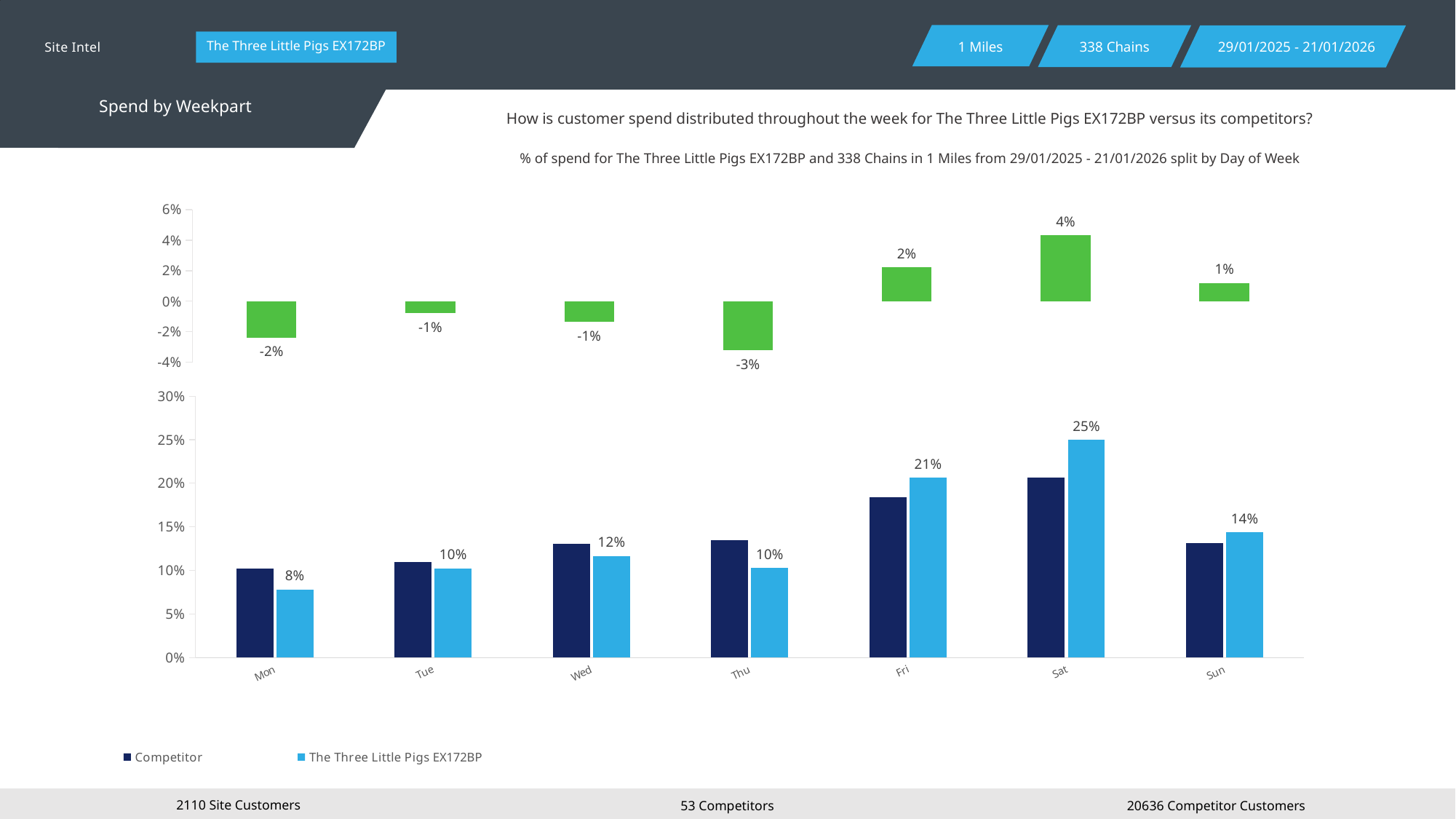
In the bottom chart, what is the difference between The Three Little Pigs EX172BP values on Sat and Fri? 4% How many series does the legend of the bottom chart list? 2 In the bottom chart, which day has the highest value for The Three Little Pigs EX172BP? Sat In the top chart, which day has the highest value? Sat In the bottom chart, on Wed, which is larger: the Competitor bar or The Three Little Pigs EX172BP bar? Competitor What type of chart is the bottom chart? Bar chart In the bottom chart, what is the value for The Three Little Pigs EX172BP on Mon? 8% In the top chart, what is the value for Thu? -3% In the bottom chart, is the Competitor value on Fri greater or less than 15%? greater In the bottom chart, which day has the lowest value for The Three Little Pigs EX172BP? Mon How many days are shown on the x axis of the bottom chart? 7 In the bottom chart, what is the value for The Three Little Pigs EX172BP on Sat? 25%